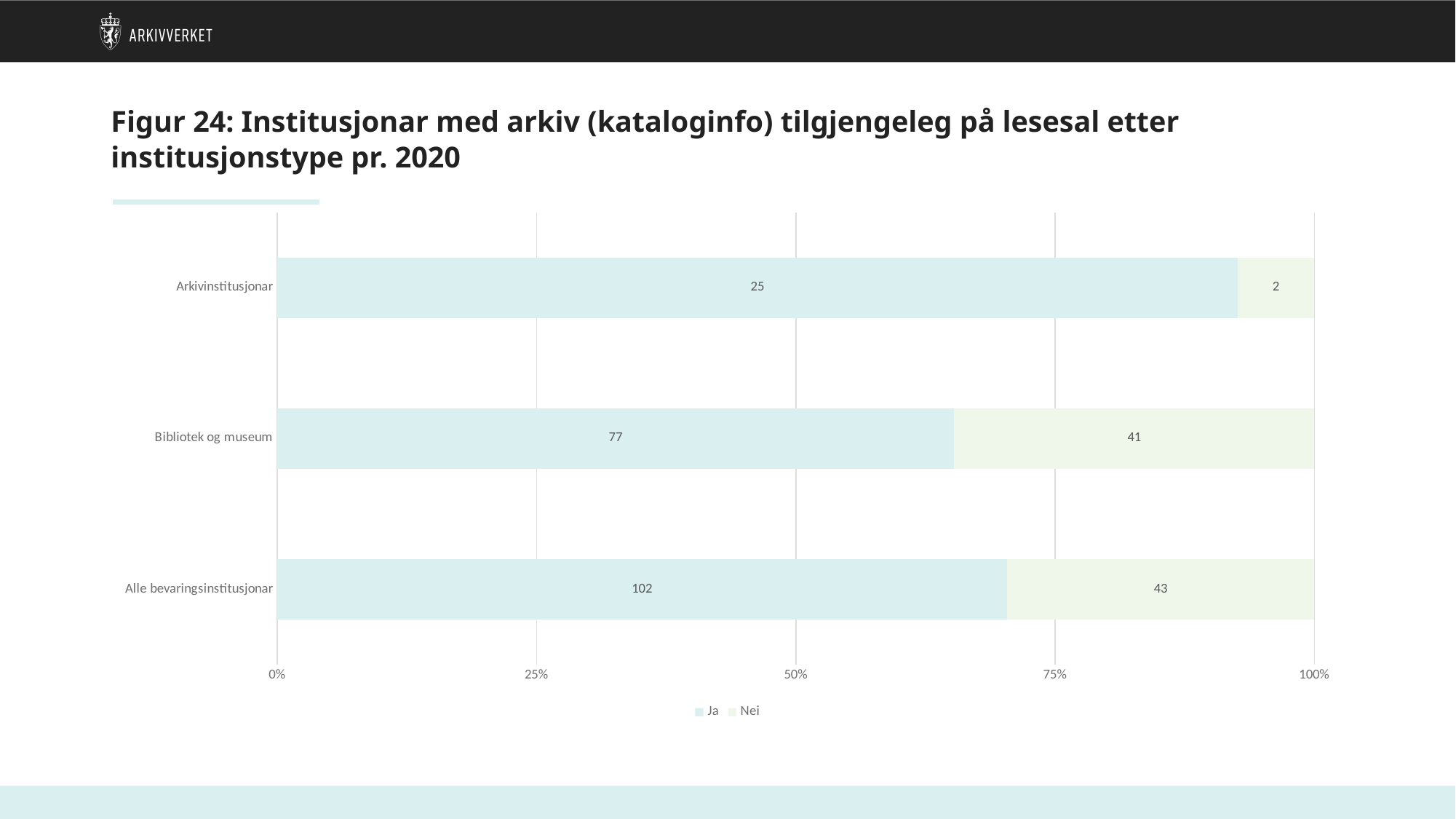
What is the value of the Nei series for Bibliotek og museum? 41 Is the Ja share of the bar for Arkivinstitusjonar greater or less than 75%? greater What is the value of the Ja series for Arkivinstitusjonar? 25 Which category has the highest Ja value? Alle bevaringsinstitusjonar Is the Ja share of the bar for Alle bevaringsinstitusjonar greater or less than 75%? less Which is larger: the Nei value for Alle bevaringsinstitusjonar or the Nei value for Bibliotek og museum? Alle bevaringsinstitusjonar What is the difference between the Ja and Nei values for Bibliotek og museum? 36 What is the total of the Ja and Nei values for Alle bevaringsinstitusjonar? 145 What is the value of the Ja series for Alle bevaringsinstitusjonar? 102 How many categories are shown on the chart? 3 What kind of chart is shown on the slide? Stacked bar chart Which category has the lowest Nei value? Arkivinstitusjonar